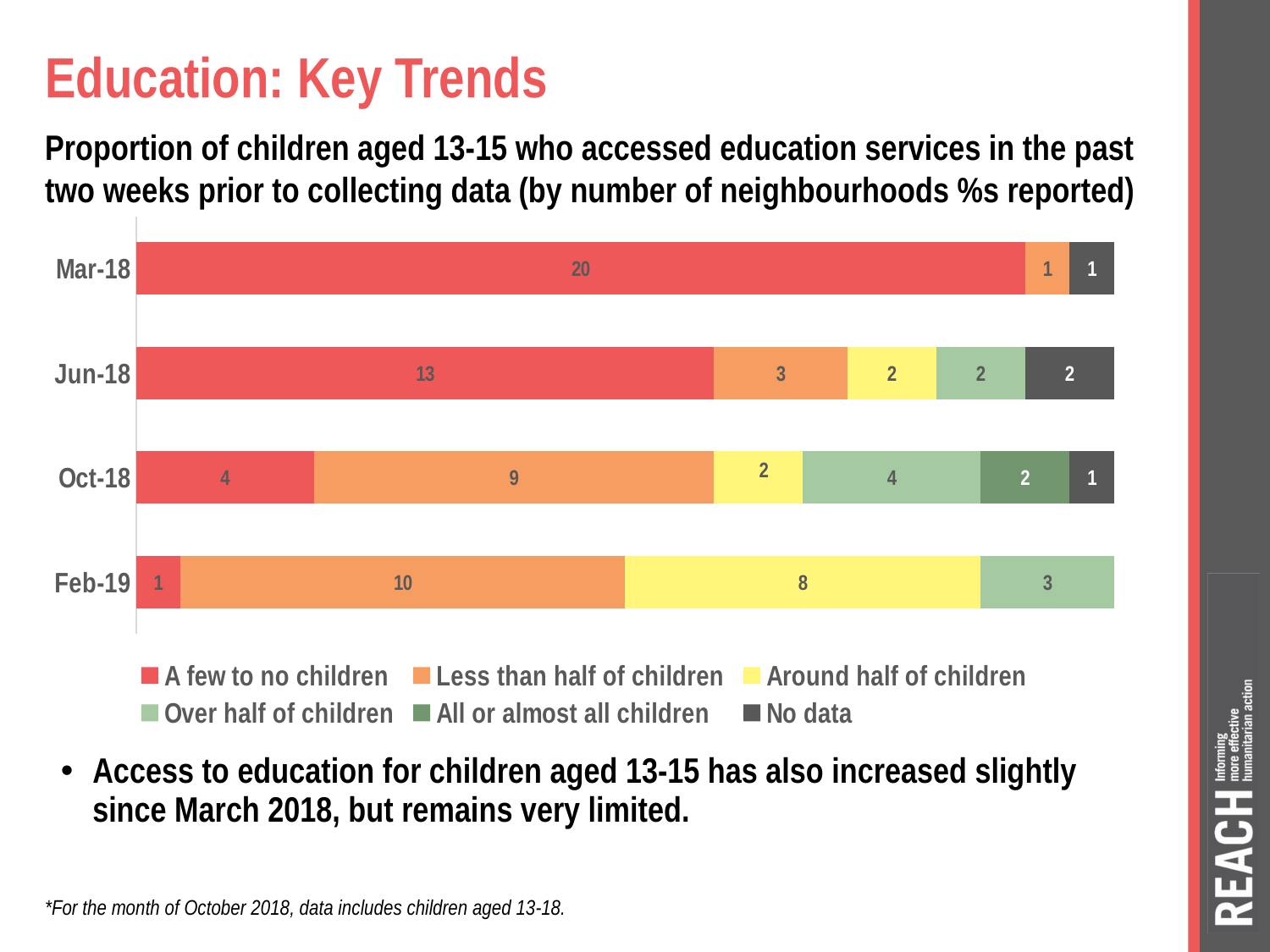
What is the value for 'Less than half of children' in Feb-19? 10 What kind of chart is shown on the slide? Stacked bar chart What is the value for 'Over half of children' in Oct-18? 4 How many series does the legend list? 6 What is the total of the stacked bar for Feb-19? 22 In which period is the value for 'A few to no children' highest? Mar-18 Which is larger: the 'Less than half of children' value in Oct-18 or in Jun-18? Oct-18 What is the value for 'A few to no children' in Mar-18? 20 How many time periods (categories) are shown on the chart? 4 What is the difference between the 'A few to no children' values for Mar-18 and Jun-18? 7 What is the value for 'Around half of children' in Feb-19? 8 In which period is the value for 'A few to no children' lowest? Feb-19